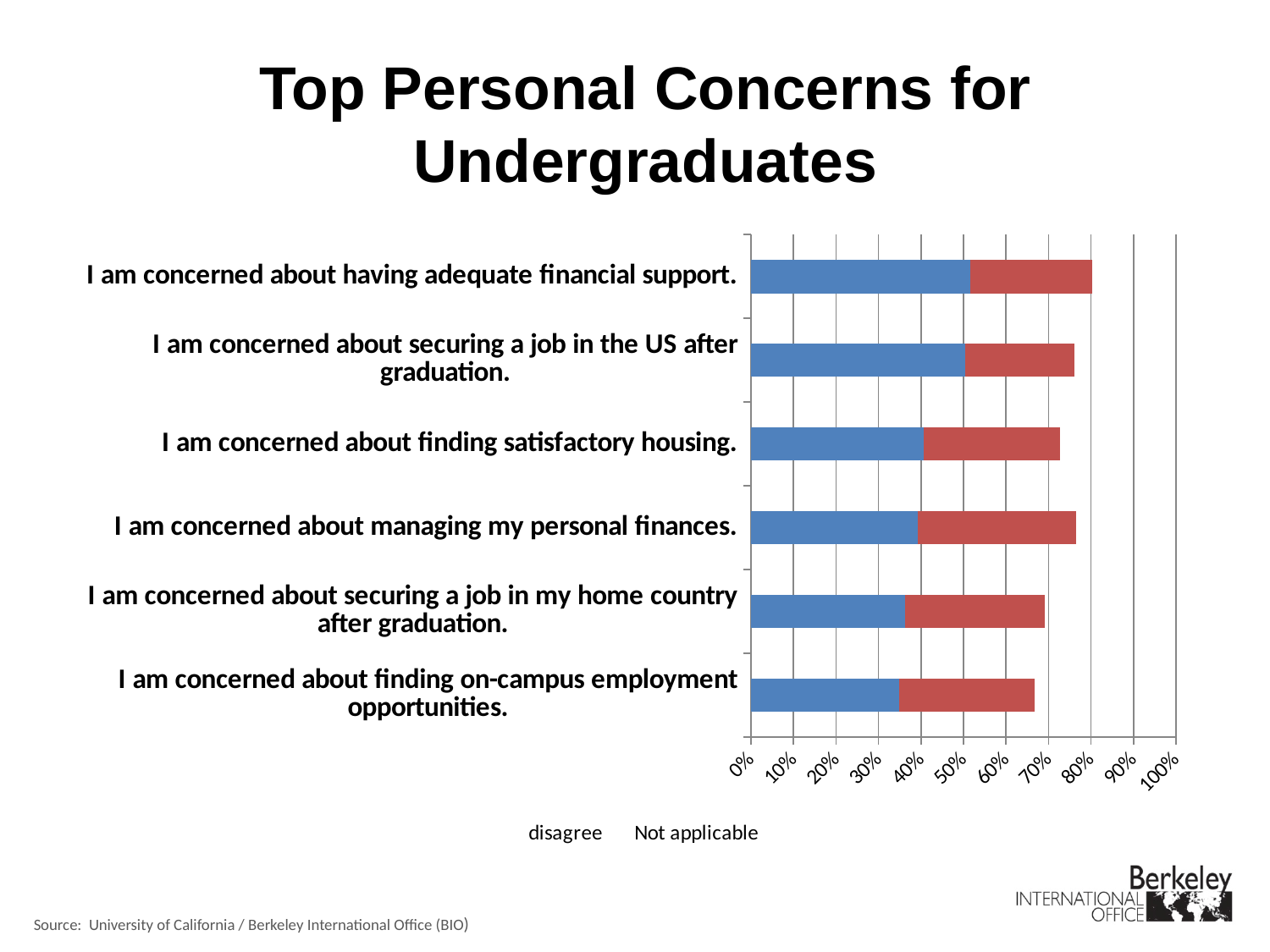
What kind of chart is shown on the slide? bar chart What is the title of the chart on the slide? Top Personal Concerns for Undergraduates How many series does the chart legend list? 2 Is the total bar length for "I am concerned about having adequate financial support." greater or less than 70%? greater Is the total bar length for "I am concerned about finding on-campus employment opportunities." greater or less than 80%? less Which concern statement has the longest total bar? I am concerned about having adequate financial support. Which has the longer total bar: "I am concerned about having adequate financial support." or "I am concerned about finding satisfactory housing."? I am concerned about having adequate financial support. How many concern statements (categories) are plotted in the chart? 6 What are the two legend entries shown below the chart? disagree, Not applicable